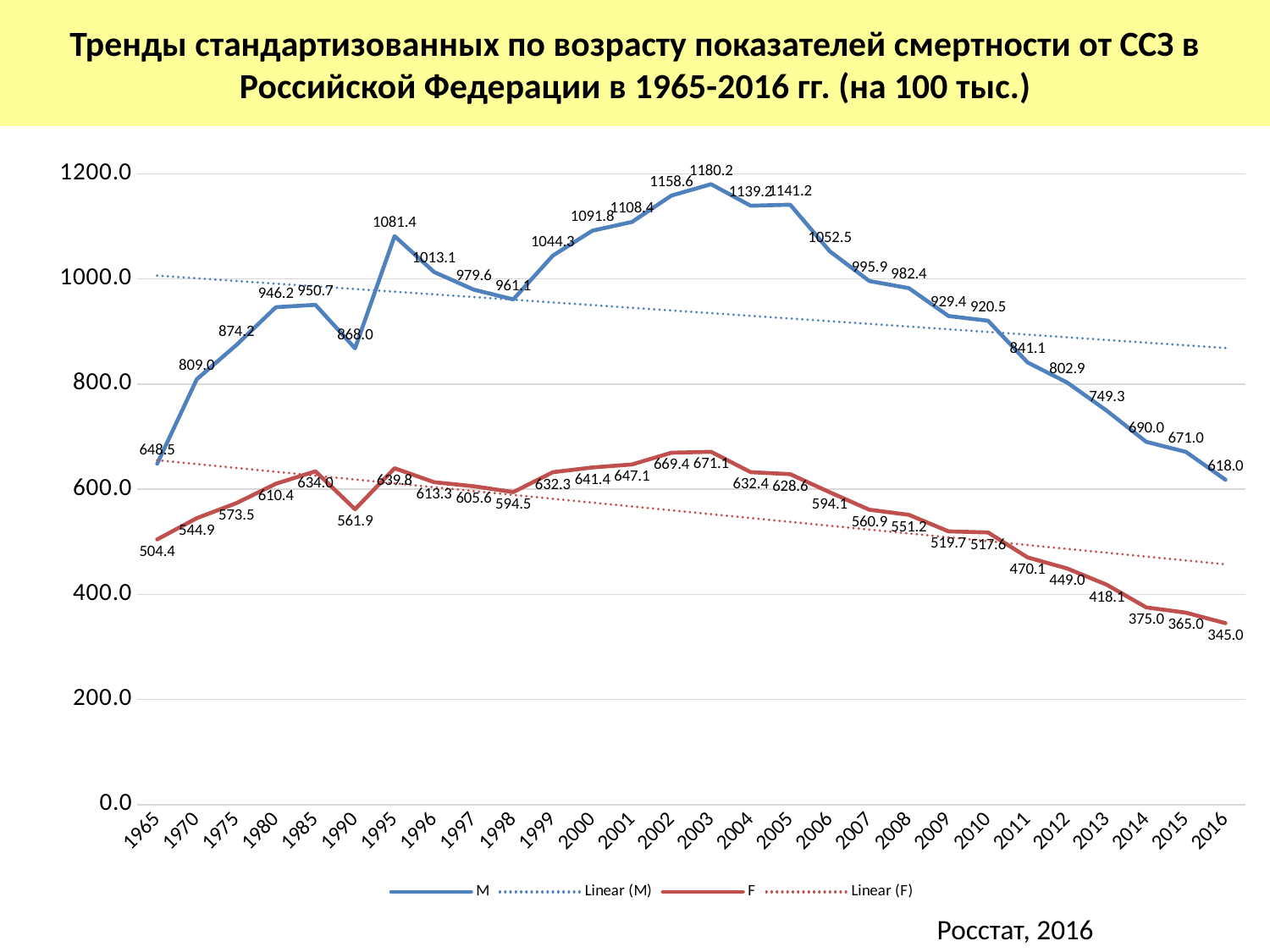
How many years are plotted along the x axis? 28 Which is larger for the M series: the value in 1990 or the value in 2010? 2010 By how much did the F series fall from 2003 to 2016? 326.1 What is the value of the F series in 1965? 504.4 How many entries does the legend list? 4 Does the M series rise or fall from 2003 to 2016? fall In which year does the M series reach its highest value? 2003 What kind of chart is shown on the slide? line chart What is the value of the F series in 2010? 517.6 In which year does the F series reach its lowest value? 2016 What is the value of the M series in 2003? 1180.2 What is the difference between the M and F values in 2016? 273.0